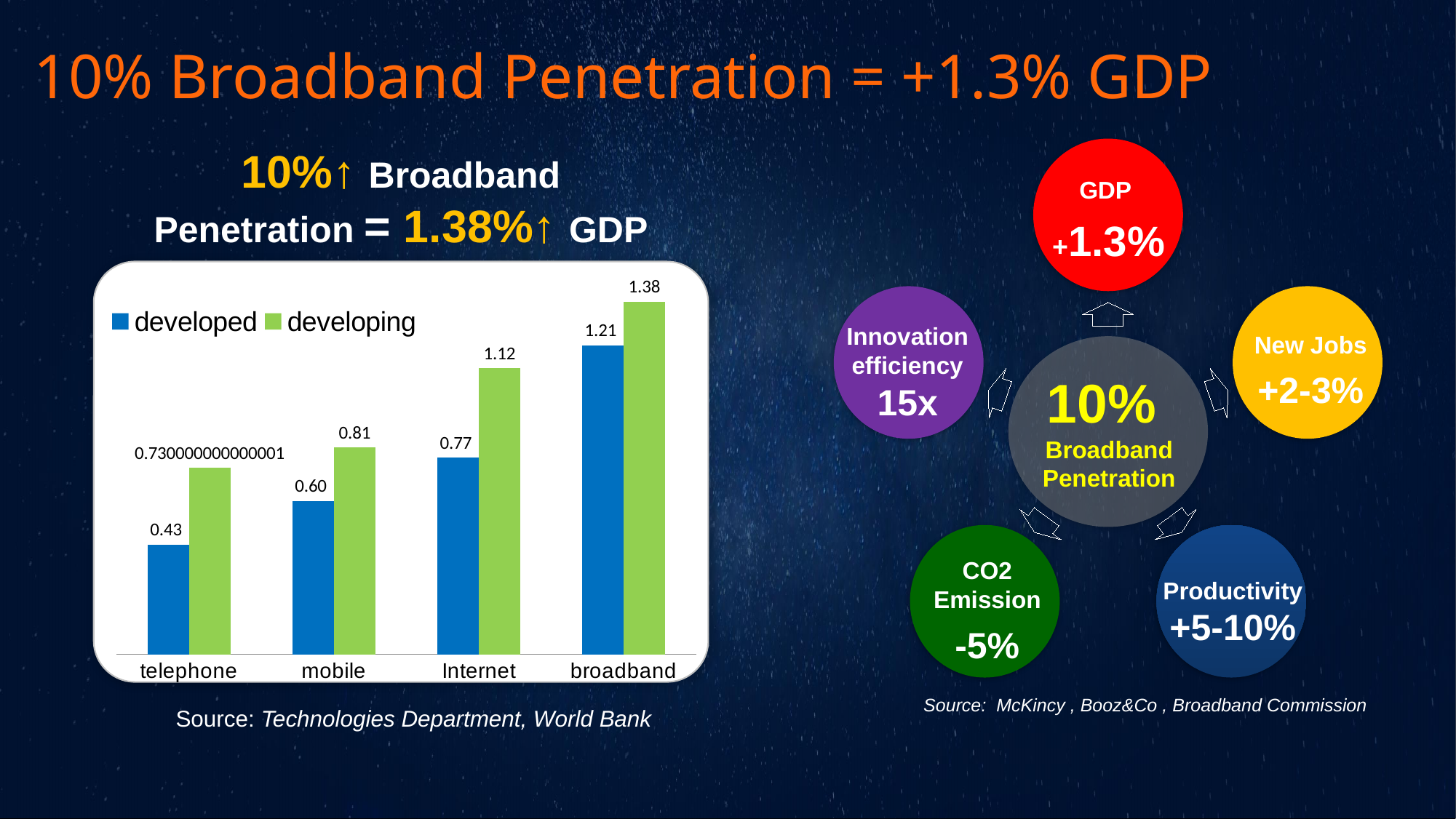
How many categories are shown on the x axis of the chart? 4 What is the difference between the developing and developed values for broadband? 0.17 What is the value for developing countries in the broadband category? 1.38 Which is larger, the developed value for Internet or the developing value for mobile? developing value for mobile What kind of chart is shown on the slide? bar chart What is the difference between the developing and developed values for Internet? 0.35 What is the value for developing countries in the Internet category? 1.12 Which category has the highest value for the developing series? broadband Which category has the lowest value for the developed series? telephone What is the value for developed countries in the broadband category? 1.21 How many series does the chart legend list? 2 What is the value for developed countries in the mobile category? 0.60